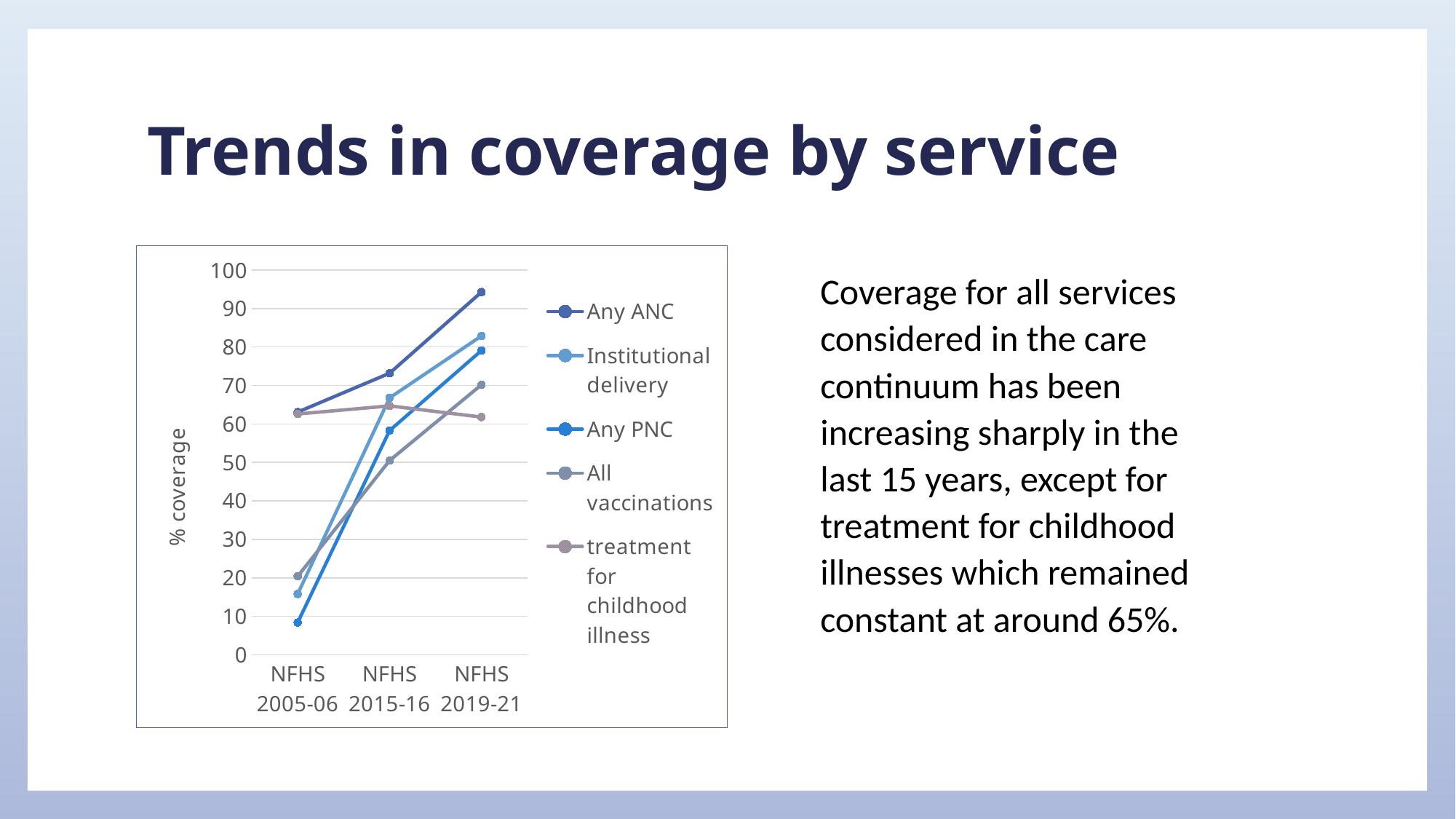
At NFHS 2019-21, which is larger: Any PNC or All vaccinations? Any PNC How many survey rounds are shown along the x axis? 3 Is the value for Any ANC at NFHS 2019-21 greater or less than 90? greater What is the label on the y axis of the chart? % coverage At NFHS 2019-21, which is larger: Institutional delivery or All vaccinations? Institutional delivery Does the Any PNC line rise or fall from NFHS 2005-06 to NFHS 2019-21? rise Which service has the lowest coverage at NFHS 2005-06? Any PNC What kind of chart is shown on the slide? line chart Which service has the highest coverage at NFHS 2019-21? Any ANC How many series does the legend list? 5 Is the value for All vaccinations at NFHS 2015-16 greater or less than 60? less Is the value for Any PNC at NFHS 2005-06 greater or less than 10? less